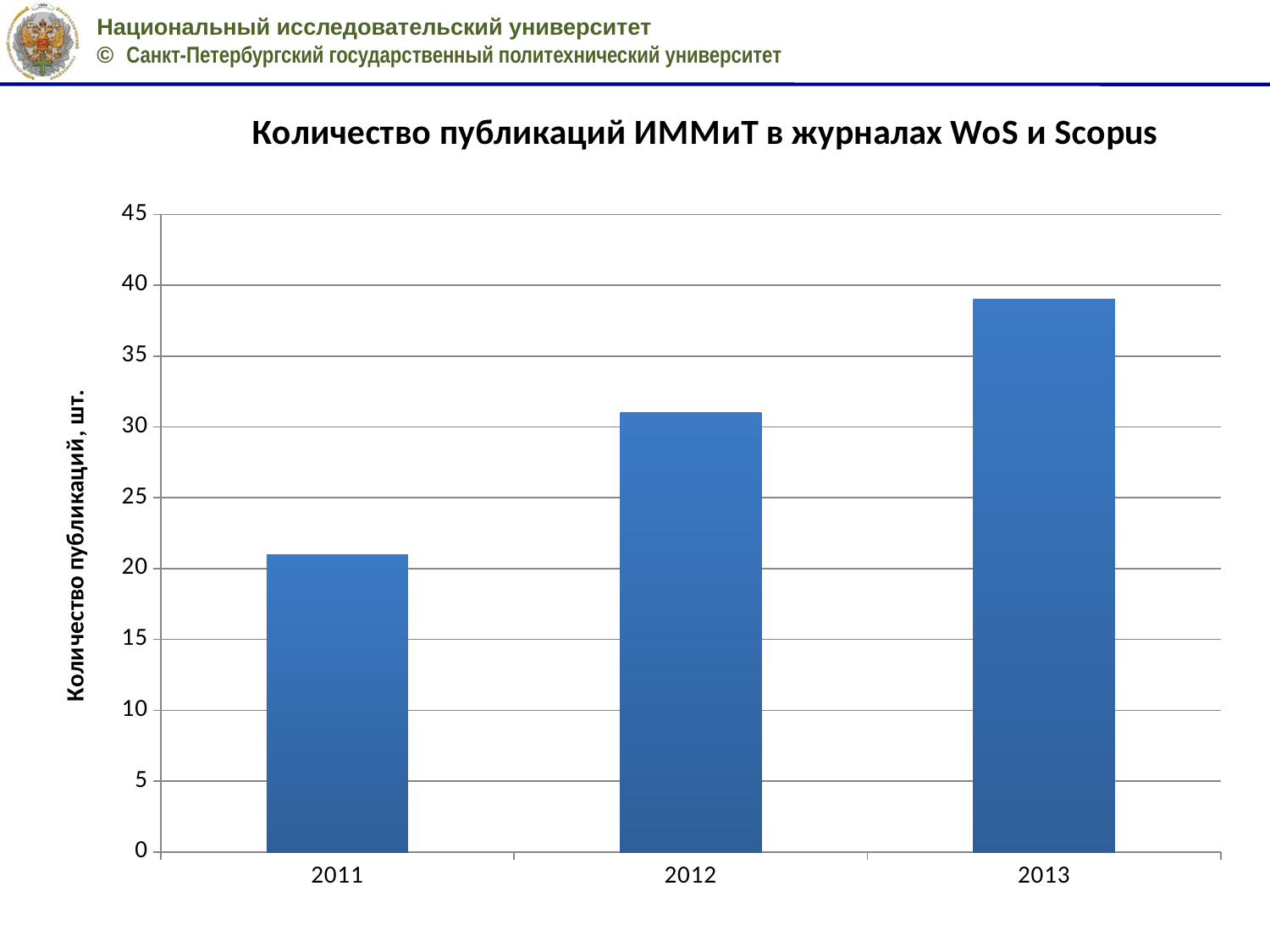
Is the value for 2011 greater or less than 20? greater Is the value for 2011 greater or less than 25? less Is the value for 2013 greater or less than 40? less Which year has the lowest number of publications? 2011 Which year has the highest number of publications? 2013 What kind of chart is shown on the slide? bar chart What is the title of the chart? Количество публикаций ИММиТ в журналах WoS и Scopus Do the values rise or fall from 2011 to 2013? rise Which is larger, the value for 2012 or the value for 2011? 2012 How many years are shown on the x axis of the chart? 3